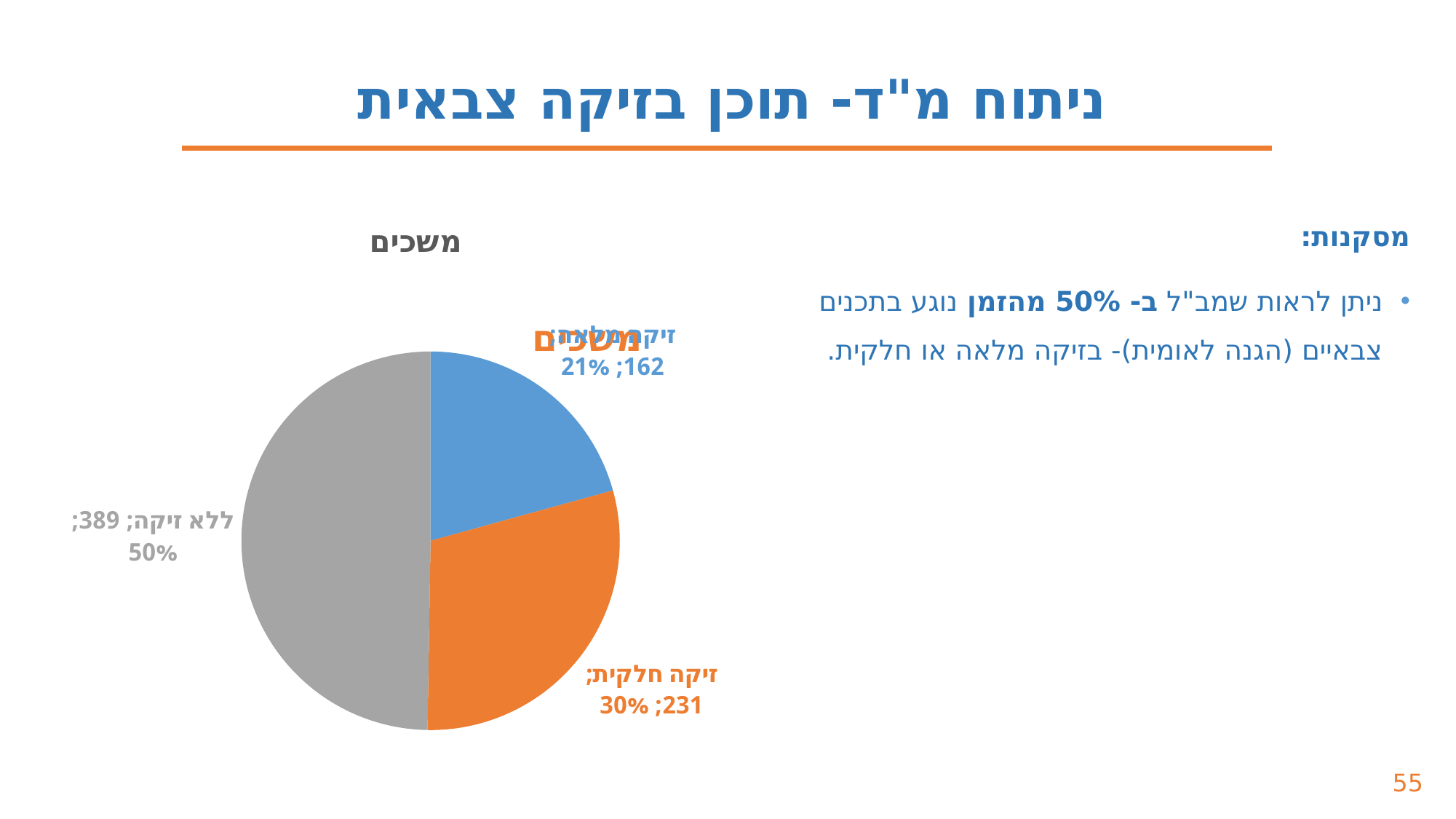
What percentage share of the pie does זיקה חלקית have? 30% What percentage share of the pie does ללא זיקה have? 50% What is the value shown for the blue slice (זיקה מלאה)? 162 How many slices does the pie chart have? 3 What is the value shown for the slice זיקה חלקית? 231 What percentage share of the pie does the blue slice (זיקה מלאה) have? 21% Which slice of the pie chart is the largest? ללא זיקה What is the difference between the values for ללא זיקה and זיקה חלקית? 158 What is the title of the pie chart? משכים What is the value shown for the slice ללא זיקה? 389 What kind of chart is shown on the slide? pie chart Which slice of the pie chart is the smallest? זיקה מלאה